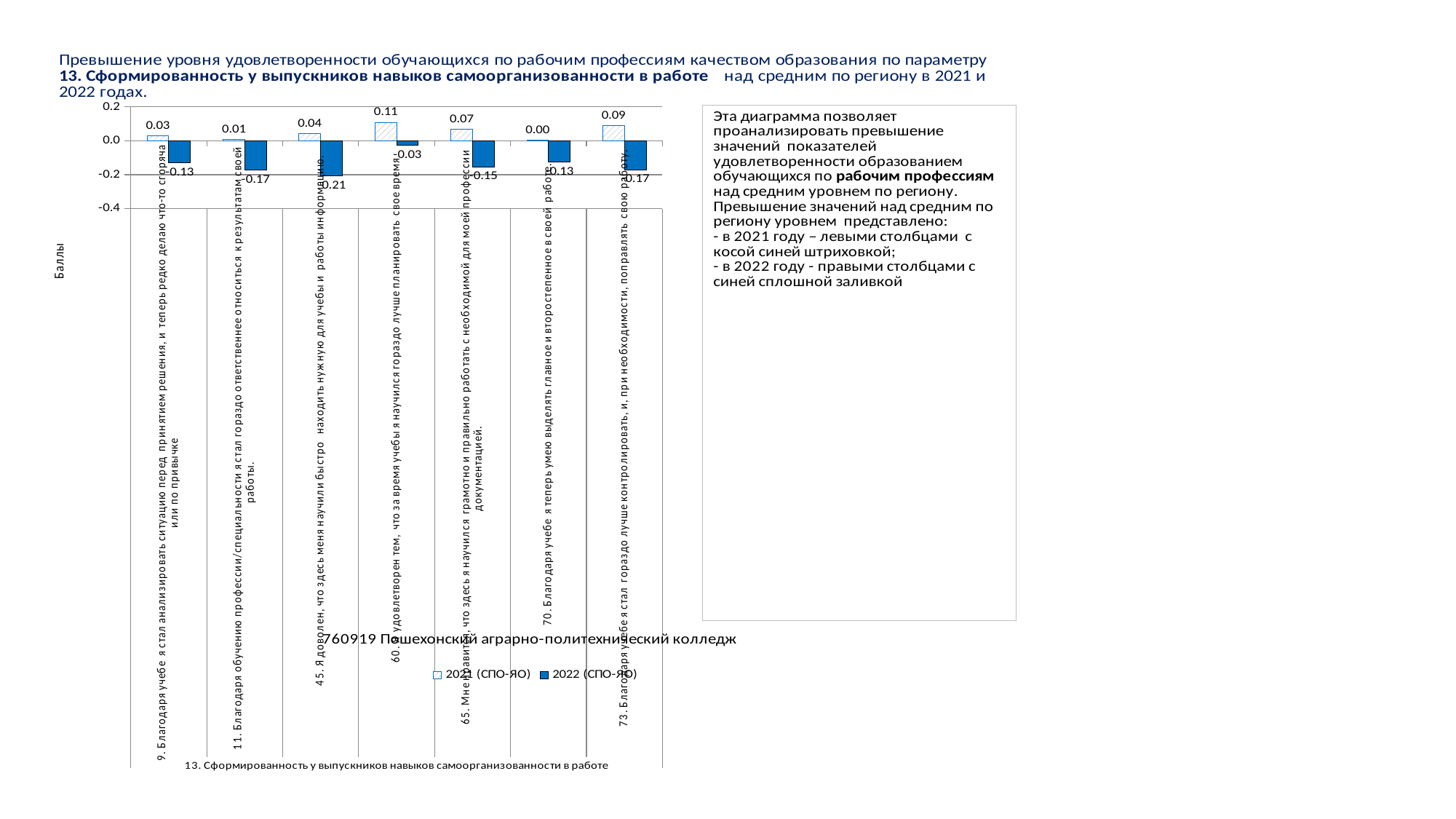
How many series does the chart legend list? 2 What is the name of the series shown with solid blue fill in the legend? 2022 (СПО-ЯО) Which is larger: the 2022 (СПО-ЯО) value for statement 60 or for statement 65? statement 60 (-0.03) What is the difference between the 2021 and 2022 (СПО-ЯО) values for statement 73 ("Благодаря учебе я стал гораздо лучше контролировать, и, при необходимости, поправлять свою работу")? 0.26 What is the 2022 (СПО-ЯО) value for statement 45 ("Я доволен, что здесь меня научили быстро находить нужную для учебы и работы информацию")? -0.21 How many categories (statements) are plotted on the chart? 7 Which statement has the highest 2021 (СПО-ЯО) value? 60. Я удовлетворен тем, что за время учебы я научился гораздо лучше планировать свое время Which statement has the lowest 2022 (СПО-ЯО) value? 45. Я доволен, что здесь меня научили быстро находить нужную для учебы и работы информацию What is the 2021 (СПО-ЯО) value for statement 60 ("Я удовлетворен тем, что за время учебы я научился гораздо лучше планировать свое время")? 0.11 What is the 2021 (СПО-ЯО) value for statement 70 ("Благодаря учебе я теперь умею выделять главное и второстепенное в своей работе")? 0.00 What type of chart is shown on the slide? bar chart What is the label of the vertical axis? Баллы